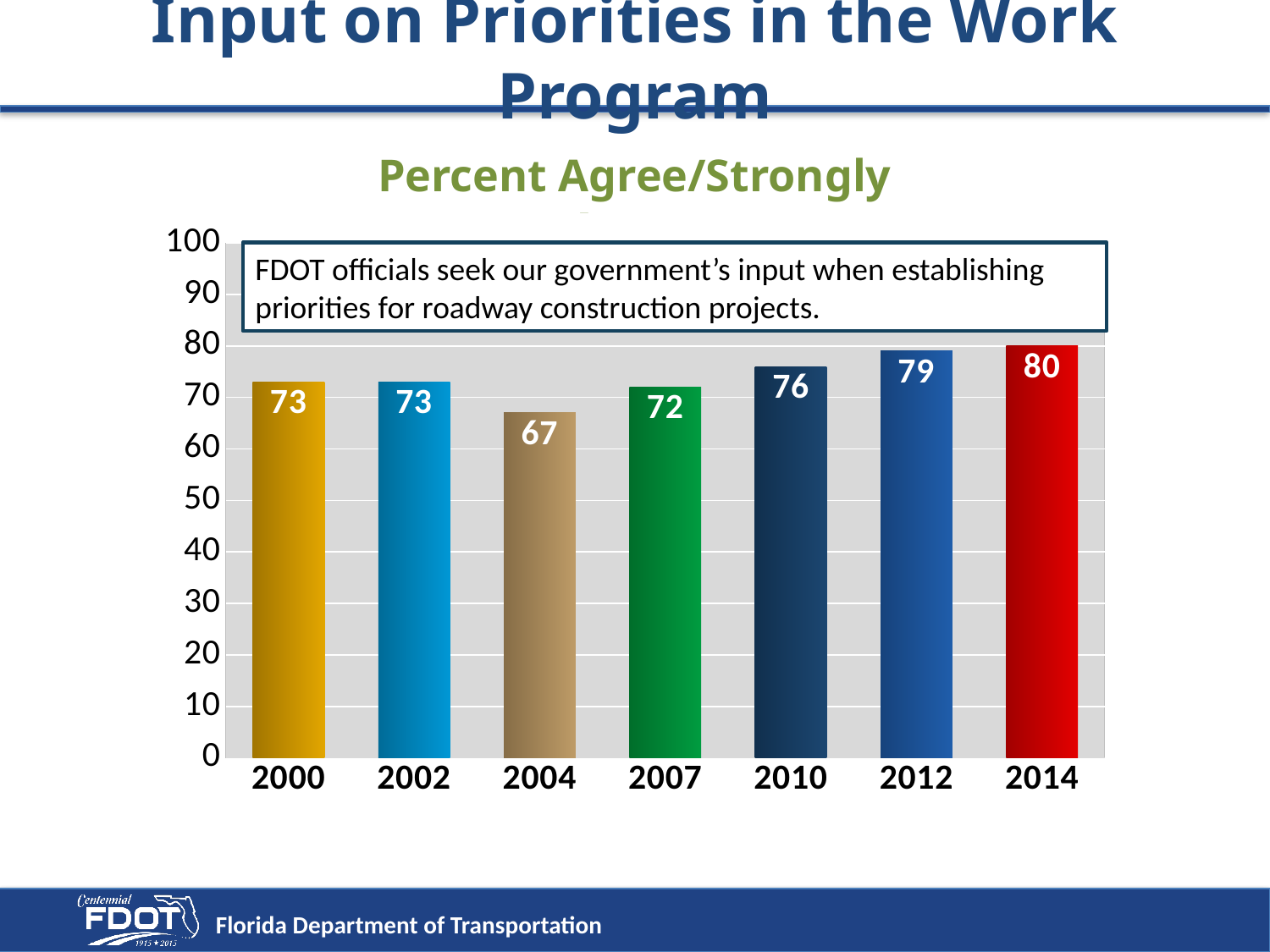
What is the value for 2004? 67 What is the difference between the values for 2012 and 2007? 7 What is the value for 2014? 80 Which is larger, the value for 2010 or the value for 2007? 2010 Is the value for 2012 greater or less than 70? greater What is the subtitle shown above the chart? Percent Agree/Strongly How many years are shown on the x axis? 7 Which year has the highest value? 2014 Which year has the lowest value? 2004 What is the difference between the values for 2014 and 2004? 13 What is the value for 2010? 76 What kind of chart is shown on the slide? bar chart